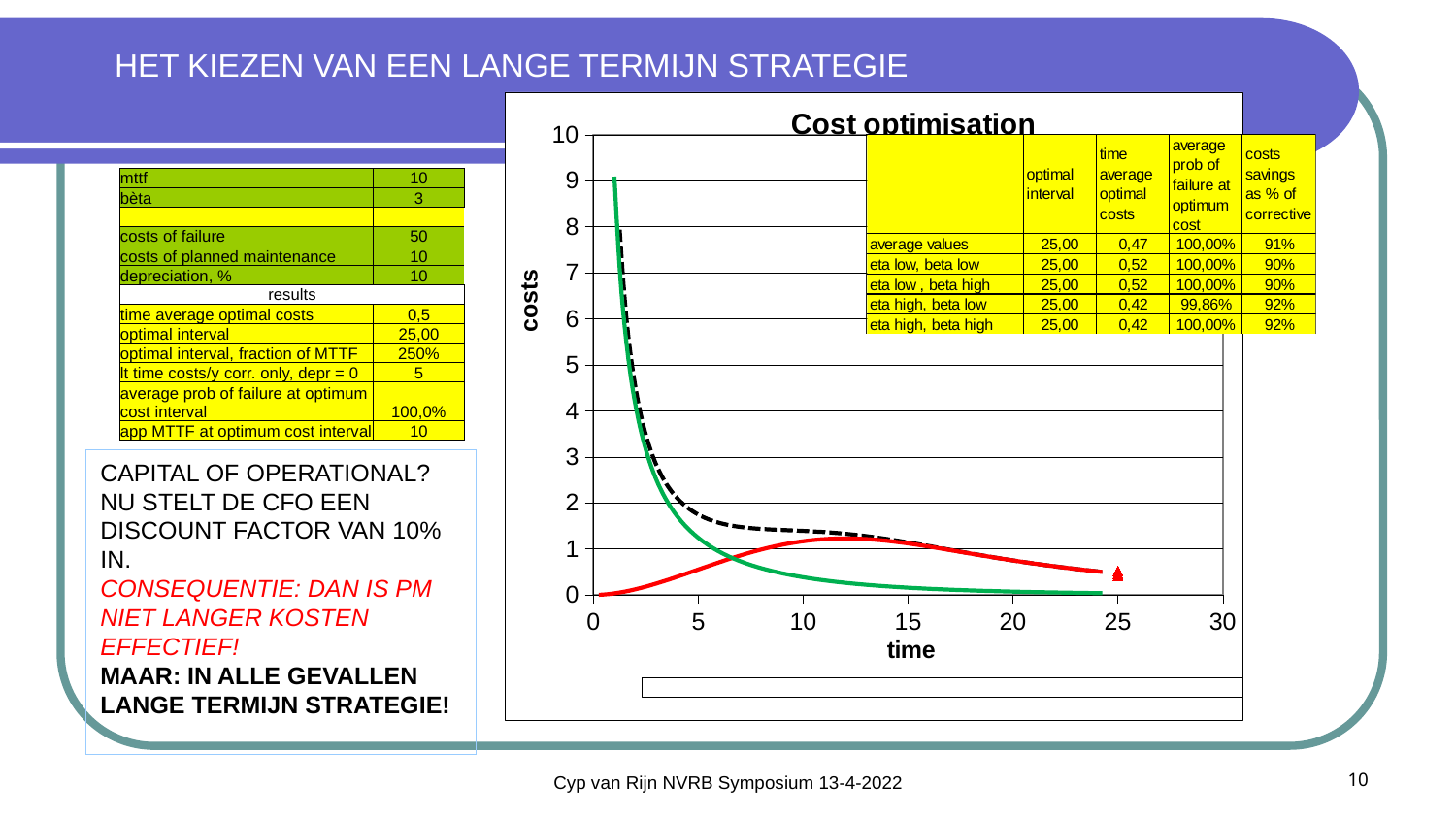
At time 5, which line has the higher value: the green line or the red line? the green line Is the value of the black dashed line at time 10 greater or less than 3? less Is the peak value of the red line greater or less than 2? less What is the highest value shown on the y axis of the chart? 10 What is the title of the chart? Cost optimisation What kind of chart is shown on the slide? line chart Is the value of the green line at time 20 greater or less than 1? less What is the label of the x axis of the chart? time What is the highest value shown on the x axis of the chart? 30 How many lines are plotted on the chart? 3 Does the green line rise or fall as time increases? fall